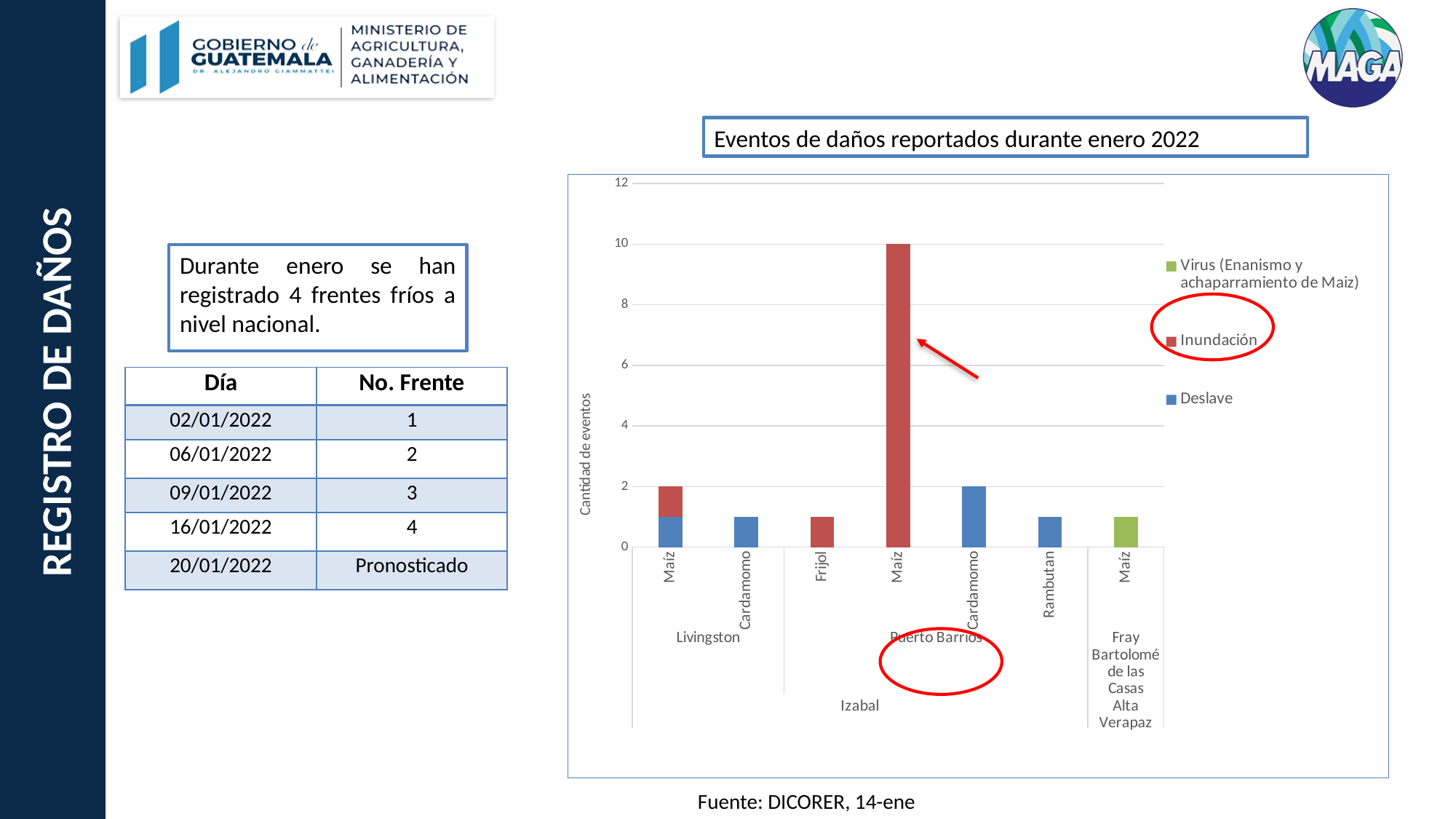
Is the value for Frijol in Puerto Barrios greater or less than 2? less What is the label of the vertical axis of the chart? Cantidad de eventos What is the difference between the events for Maíz in Puerto Barrios and Cardamomo in Puerto Barrios? 8 What is the total height of the stacked bar for Maíz in Livingston? 2 How many events are shown for Cardamomo in Puerto Barrios? 2 What kind of chart is shown under the title 'Eventos de daños reportados durante enero 2022'? bar chart Which bar has the highest number of events in the chart? Maíz (Puerto Barrios) How many events are shown for Maíz in Puerto Barrios? 10 How many series does the legend of the chart list? 3 Which series are listed in the chart legend? Virus (Enanismo y achaparramiento de Maiz), Inundación, Deslave How many bars are plotted in the chart? 7 Which is larger: the bar for Maíz in Puerto Barrios or the bar for Rambutan in Puerto Barrios? Maíz in Puerto Barrios